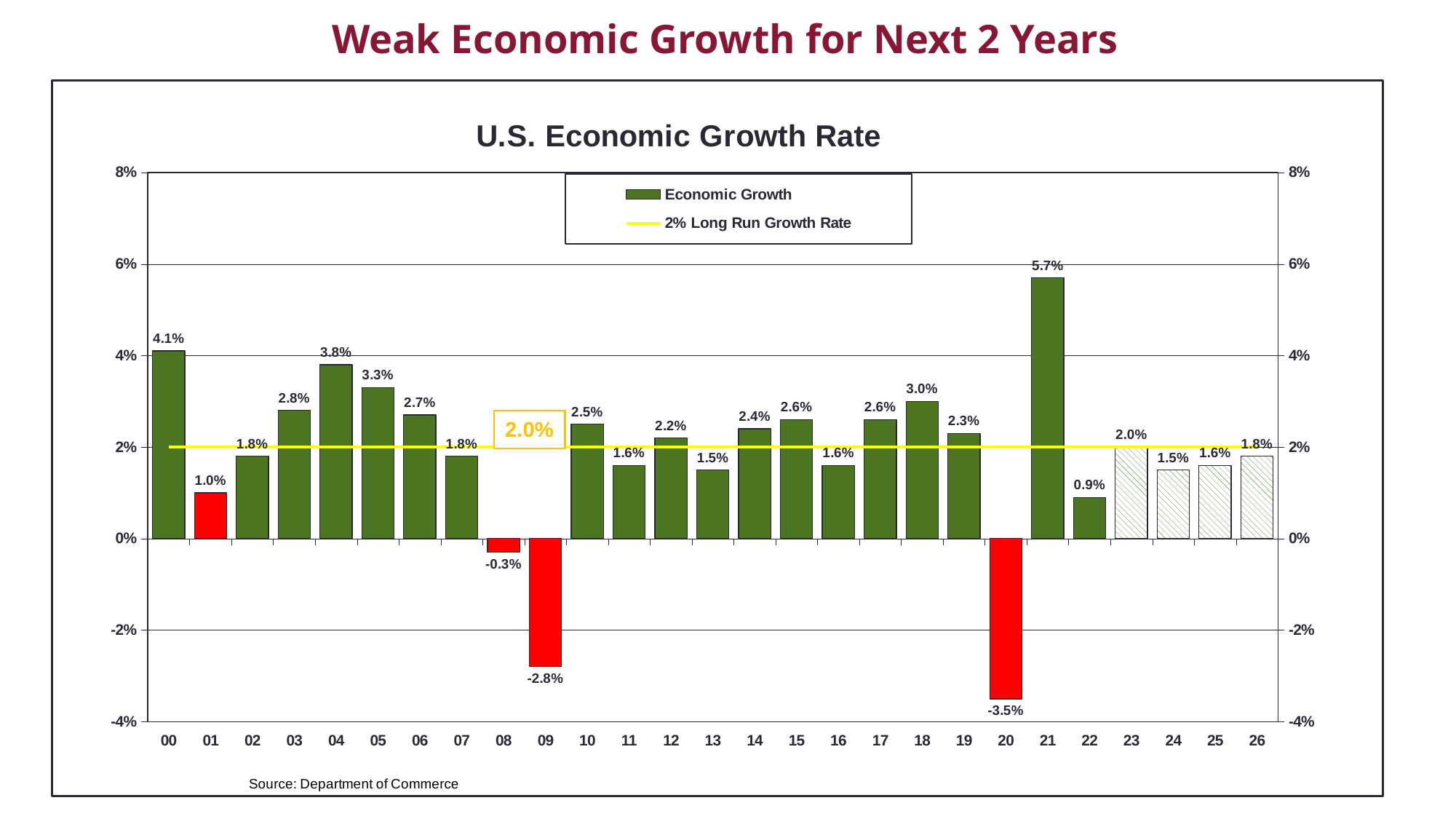
What type of chart is used to show the U.S. Economic Growth Rate? bar chart What is the U.S. economic growth rate shown for 2021? 5.7% How many years are shown on the x axis of the chart? 27 What is the projected economic growth rate for 2026? 1.8% What is the economic growth rate shown for 2009? -2.8% Which year has the lowest economic growth rate on the chart? 20 Which year had a higher growth rate, 2004 or 2005? 04 What is the difference between the growth rate in 2000 and the growth rate in 2001? 3.1% How many entries does the legend list? 2 Is the growth rate for 2022 greater or less than 2%? less Which year has the highest economic growth rate on the chart? 21 What is the long run growth rate marked by the yellow line? 2.0%